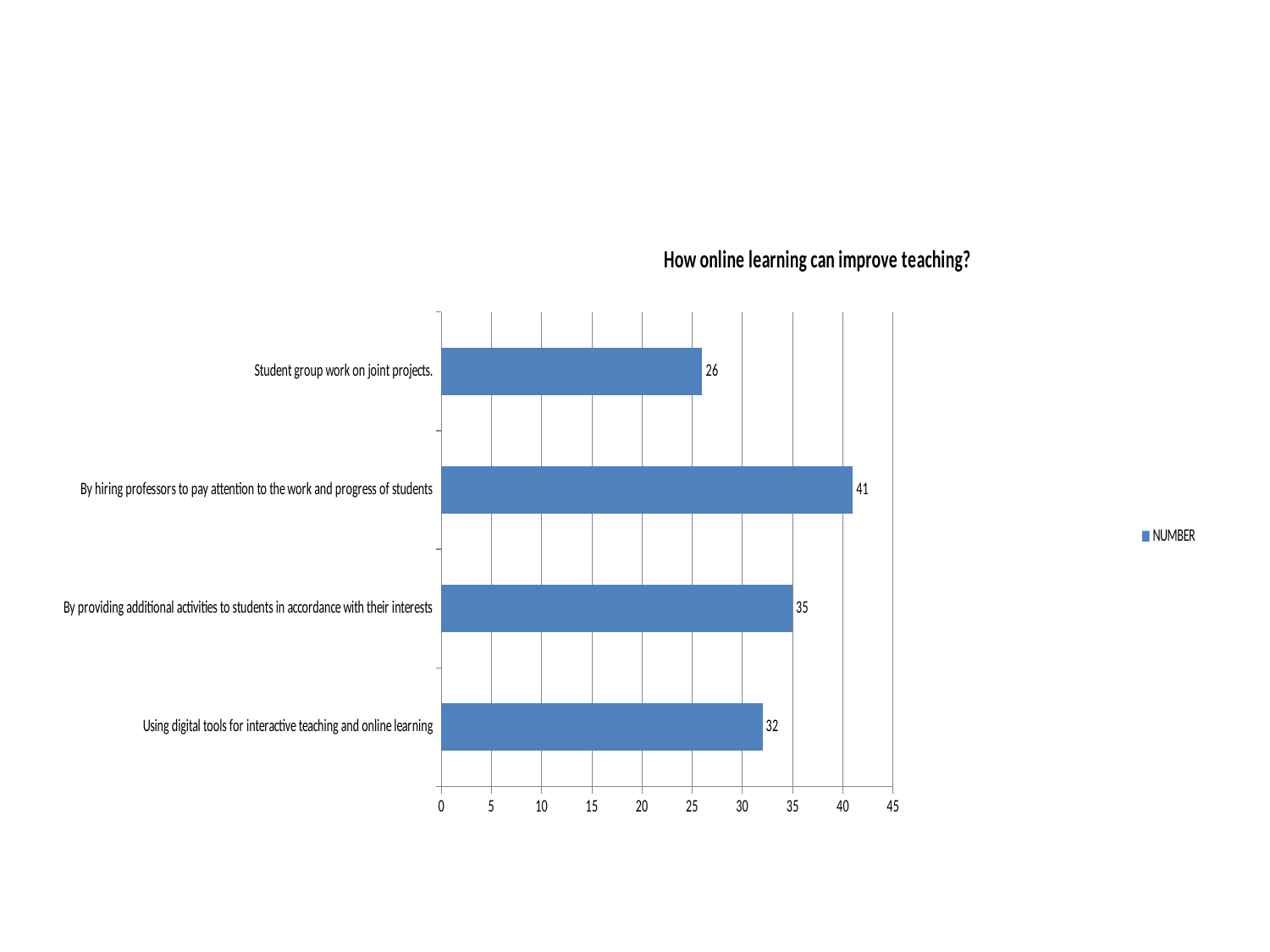
What is the value for "Using digital tools for interactive teaching and online learning"? 32 Is the value for "Student group work on joint projects." greater or less than 30? less What is the value for "Student group work on joint projects."? 26 What kind of chart is shown on the slide? Bar chart What is the value for "By hiring professors to pay attention to the work and progress of students"? 41 Which category has the highest value? By hiring professors to pay attention to the work and progress of students Which category has the lowest value? Student group work on joint projects. Which is larger: the value for "By providing additional activities to students in accordance with their interests" or the value for "Using digital tools for interactive teaching and online learning"? By providing additional activities to students in accordance with their interests How many categories are shown in the chart? 4 What is the difference between the values for "By hiring professors to pay attention to the work and progress of students" and "Student group work on joint projects."? 15 How many series does the legend list? 1 What is the title of the chart? How online learning can improve teaching?